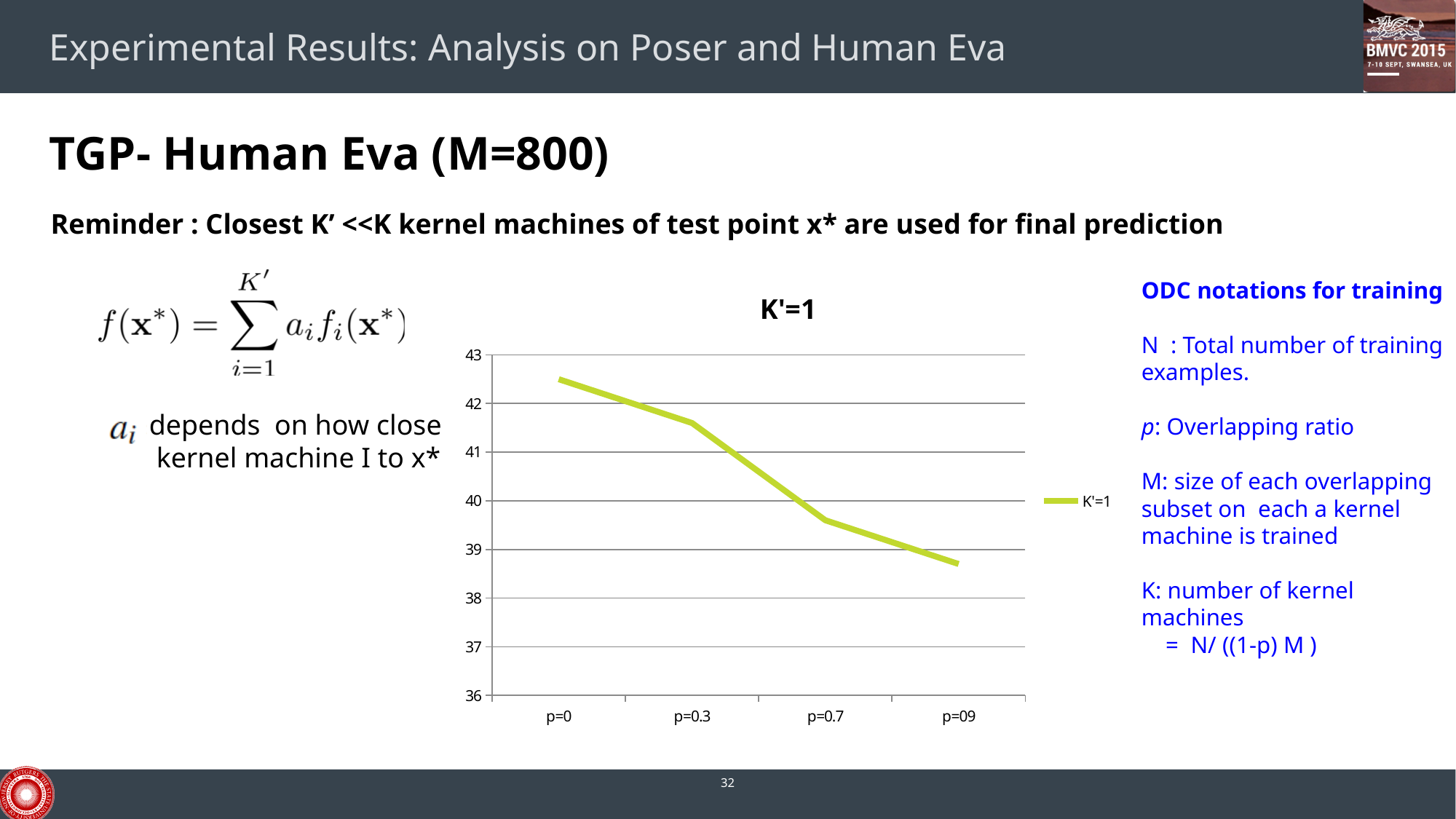
Do the values rise or fall as p increases along the x axis? fall How many series does the chart legend list? 1 What is the title of the chart? K'=1 Which has a larger value, p=0.3 or p=0.7? p=0.3 What is the name of the series shown in the chart legend? K'=1 How many points are plotted along the x axis of the chart? 4 Is the value for p=09 greater or less than 39? less Which x-axis category has the lowest value? p=09 Is the value for p=0 greater or less than 42? greater Which x-axis category has the highest value? p=0 What kind of chart is shown on the slide? line chart Is the value for p=0.7 greater or less than 40? less